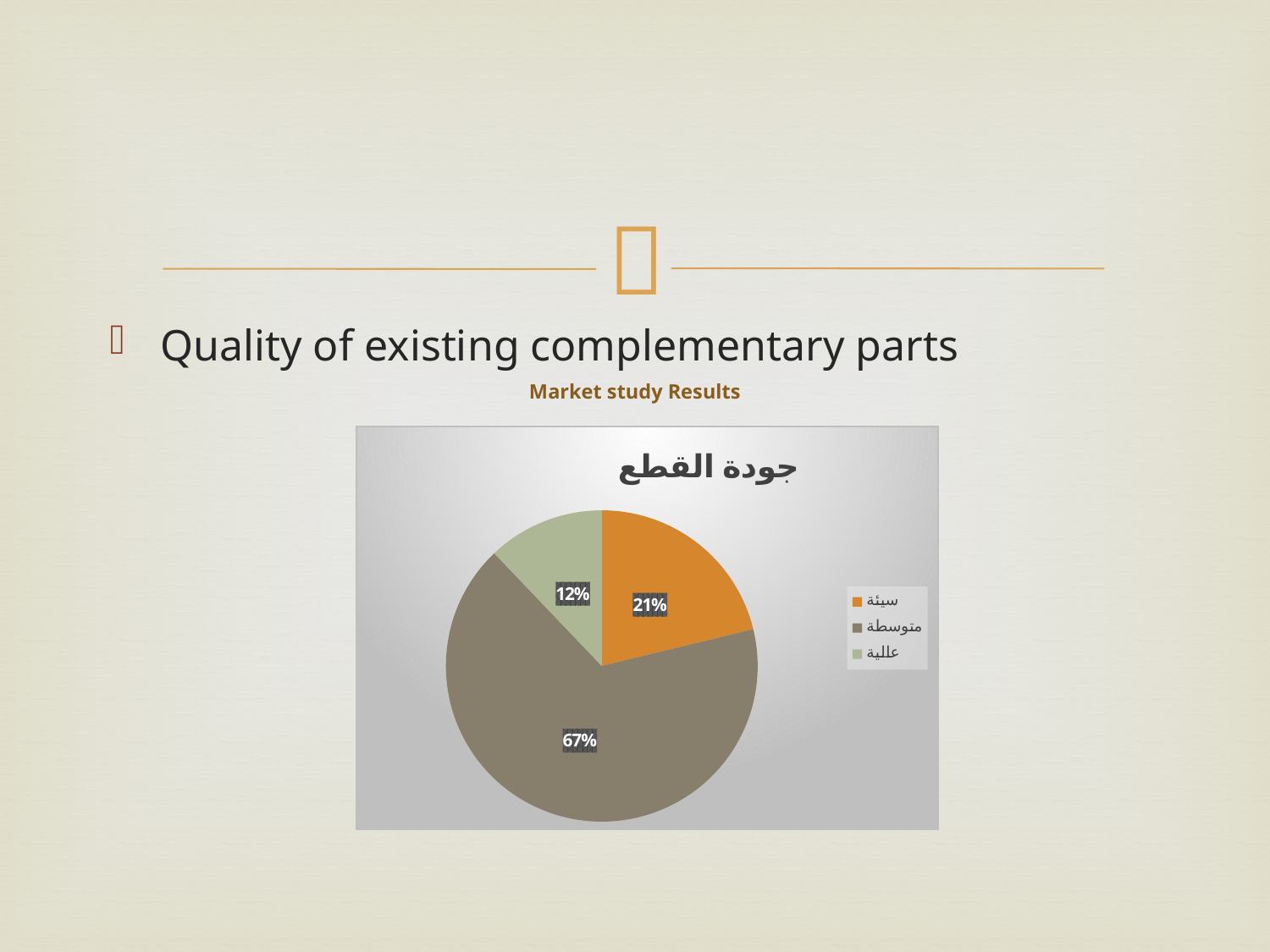
Which category has the largest slice of the pie? متوسطة What percentage of the pie is the slice for عالية? 12% What type of chart is shown on the slide? pie chart What colour is the slice for سيئة? orange What is the difference in percentage points between the متوسطة slice and the سيئة slice? 46 Which category has the smallest slice of the pie? عالية What percentage of the pie is the slice for متوسطة? 67% Which slice is larger, سيئة or عالية? سيئة What percentage of the pie is the slice for سيئة? 21% How many slices does the pie chart have? 3 How many entries does the legend list? 3 What is the title of the chart? جودة القطع